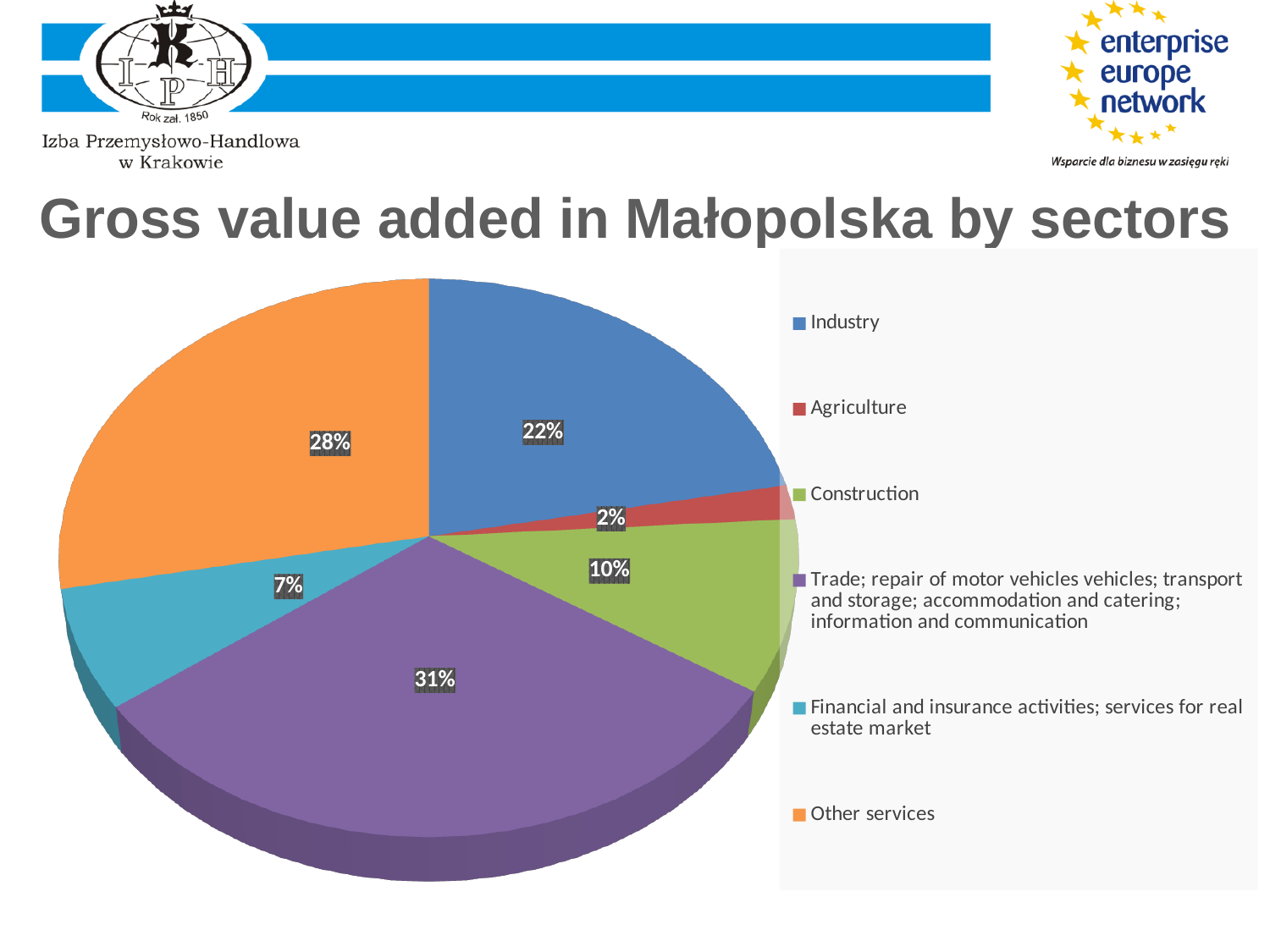
What is the title of the chart? Gross value added in Małopolska by sectors What share of gross value added does Financial and insurance activities; services for real estate market account for? 7% What share of gross value added does Other services account for? 28% What share of gross value added does Construction account for? 10% What is the difference in percentage points between the Other services share and the Industry share? 6 How many sectors are shown in the pie chart? 6 What type of chart is shown on the slide? Pie chart Which sector has the smallest share of gross value added? Agriculture Which has a larger share, Construction or Financial and insurance activities; services for real estate market? Construction What share of gross value added does Agriculture account for? 2% What share of gross value added does Industry account for? 22% Which sector has the largest share of gross value added? Trade; repair of motor vehicles vehicles; transport and storage; accommodation and catering; information and communication